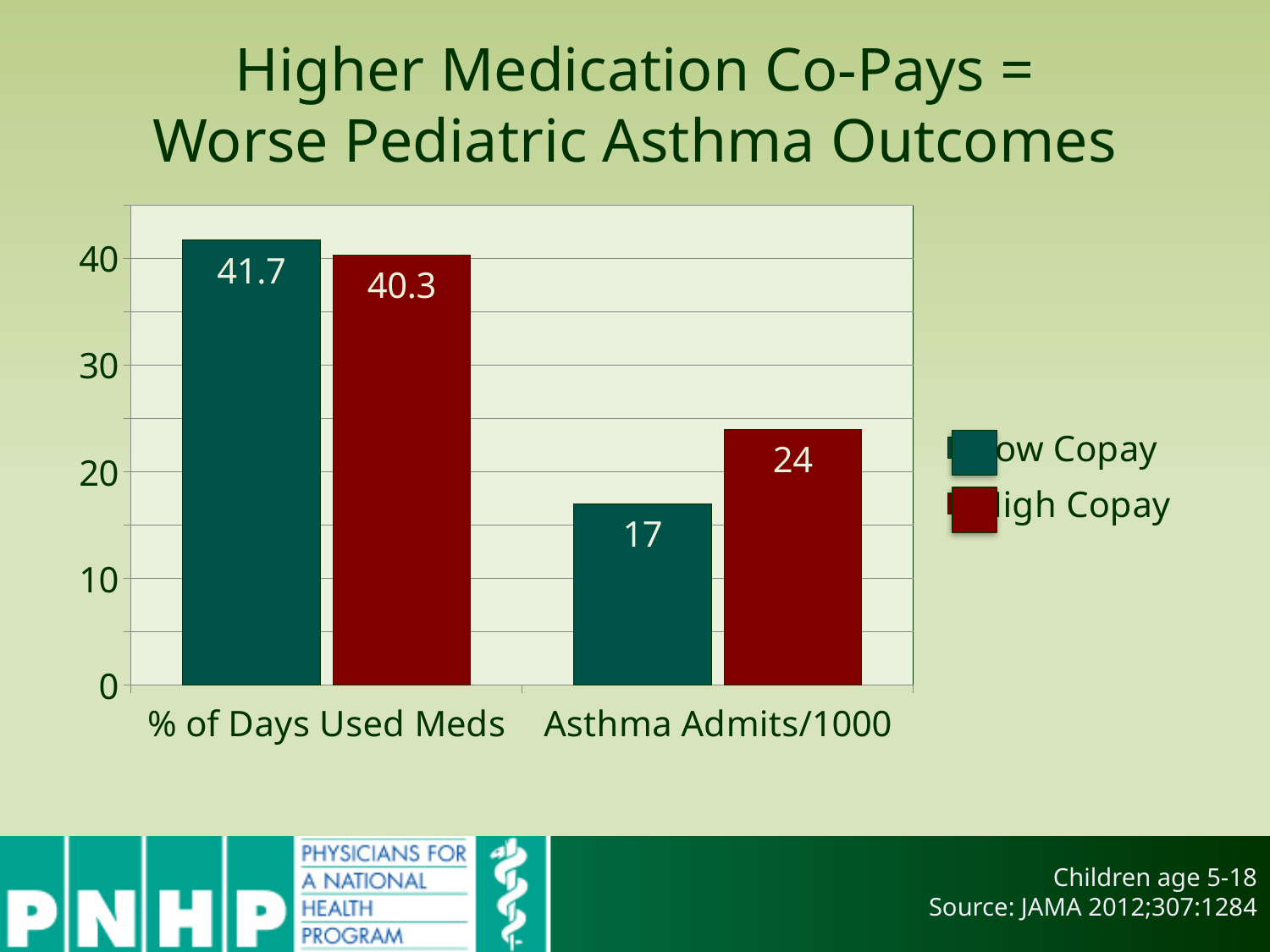
How many series does the legend list? 2 What is the value for Low Copay in the Asthma Admits/1000 category? 17 What is the difference between the Low Copay and High Copay values for Asthma Admits/1000? 7 Which copay group has the higher value for Asthma Admits/1000? High Copay How many categories are shown on the x axis? 2 Which bar has the lowest value on the chart? Low Copay, Asthma Admits/1000 What is the value for Low Copay in the % of Days Used Meds category? 41.7 What is the difference between the Low Copay and High Copay values for % of Days Used Meds? 1.4 What kind of chart is shown on the slide? Bar chart What is the value for High Copay in the Asthma Admits/1000 category? 24 What is the value for High Copay in the % of Days Used Meds category? 40.3 Which copay group has the higher value for % of Days Used Meds? Low Copay